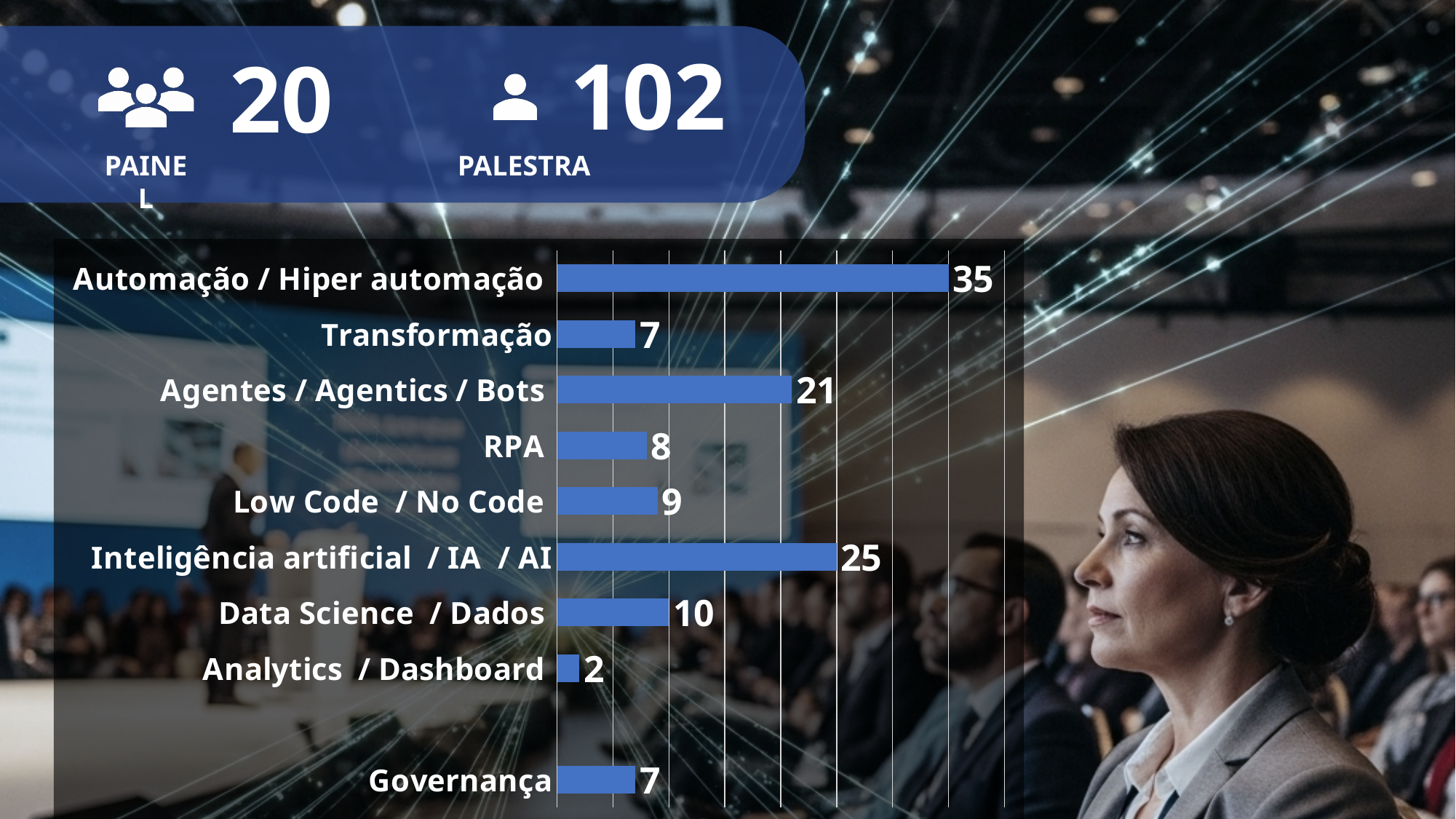
What colour are the bars in the chart? Blue What is the difference between the values for Agentes / Agentics / Bots and RPA? 13 What is the difference between the values for Automação / Hiper automação and Inteligência artificial / IA / AI? 10 What is the value for Low Code / No Code? 9 Which is larger, the value for Data Science / Dados or the value for Governança? Data Science / Dados What kind of chart is shown on the slide? Bar chart What is the value for Inteligência artificial / IA / AI? 25 What is the value for Agentes / Agentics / Bots? 21 What is the value for Automação / Hiper automação? 35 Which category has the lowest value? Analytics / Dashboard Which category has the highest value? Automação / Hiper automação What is the value for Data Science / Dados? 10